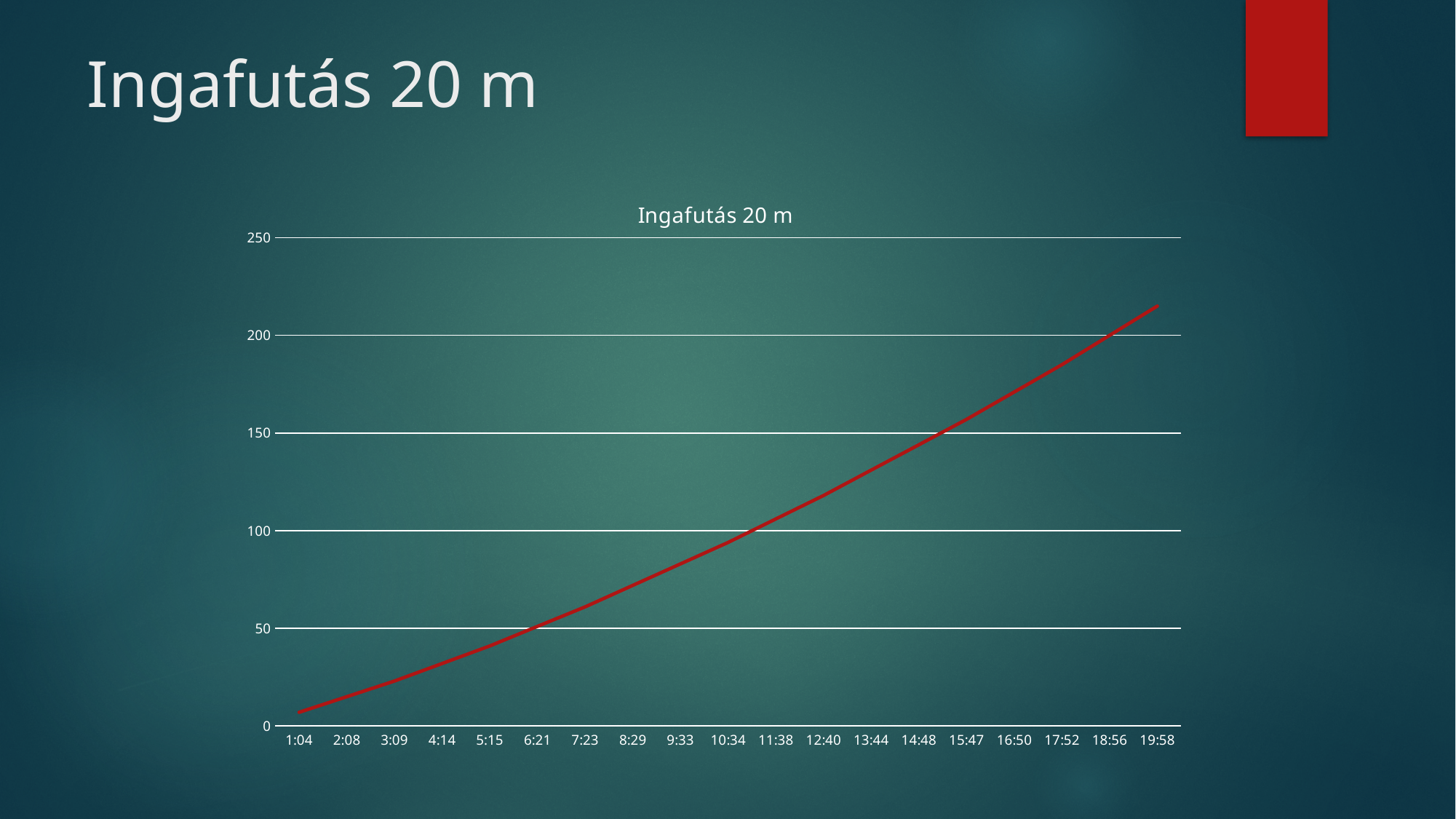
At which x-axis label is the plotted value highest? 19:58 How many points are plotted along the x axis of the chart? 19 What colour is the plotted line in the chart? red Is the value at 9:33 greater or less than 100? less Is the value at 15:47 greater or less than 150? greater Which has the larger value, 5:15 or 12:40? 12:40 Do the values rise or fall along the x axis from 1:04 to 19:58? rise What kind of chart is shown on the slide? line chart Is the value at 1:04 greater or less than 50? less At which x-axis label is the plotted value lowest? 1:04 What is the title of the chart? Ingafutás 20 m